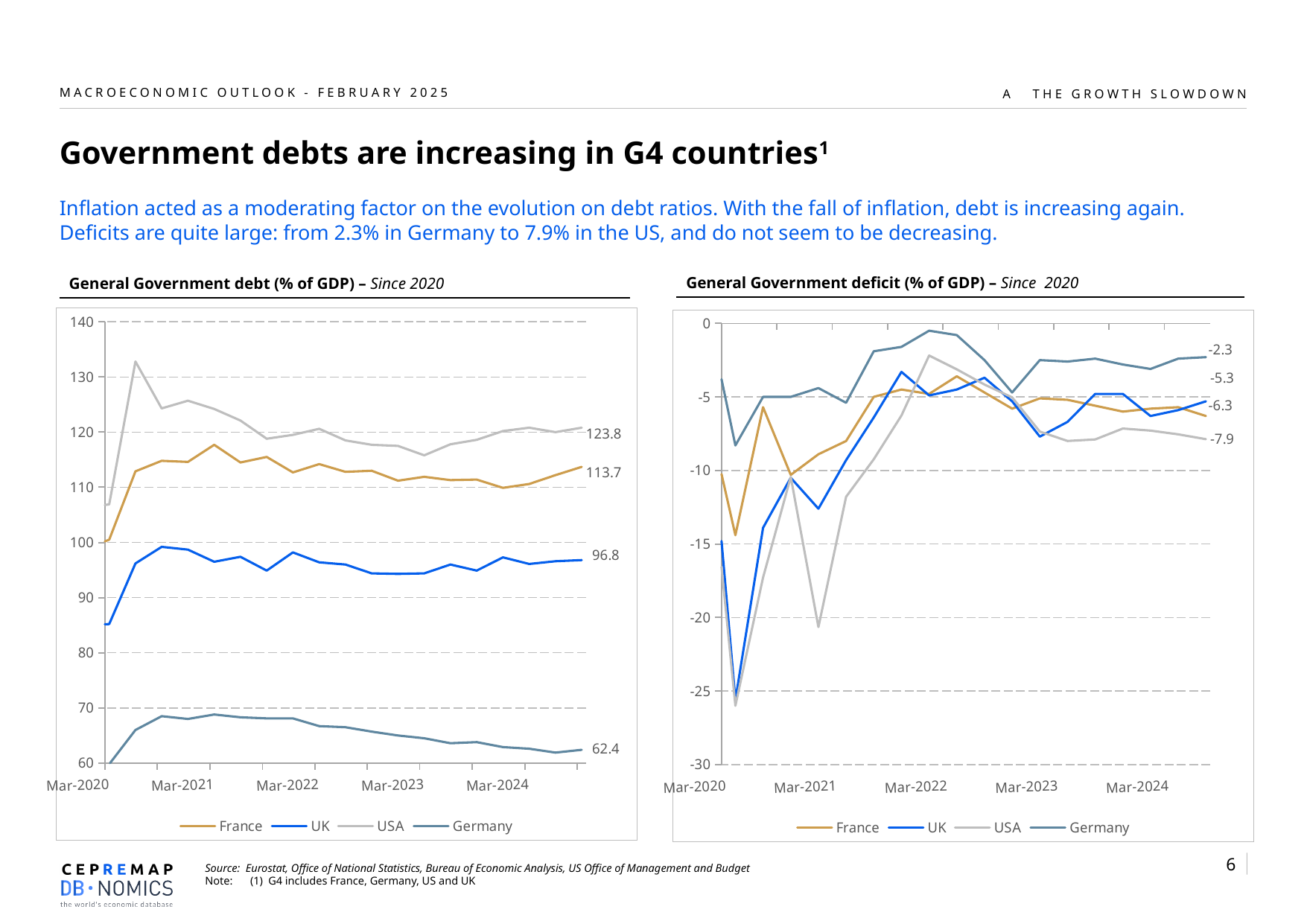
How many series does the legend of the General Government deficit chart list? 4 In the General Government debt chart, which country has the highest debt ratio at the end of the series? USA In the General Government deficit chart, what is the latest value shown for Germany? -2.3 In the General Government debt chart, what is the latest value shown for France? 113.7 In the General Government debt chart, what is the latest value shown for the USA? 123.8 In the General Government debt chart, is the latest value for the UK greater or less than 100? less In the General Government debt chart, what is the difference between the latest values for the USA and the UK? 27.0 In the General Government debt chart, what is the latest value shown for Germany? 62.4 In the General Government deficit chart, which country has the largest deficit (lowest value) at the end of the series? USA In the General Government deficit chart, what is the latest value shown for the USA? -7.9 In the General Government debt chart, which country has the lowest debt ratio at the end of the series? Germany What kind of chart is the General Government debt chart? Line chart